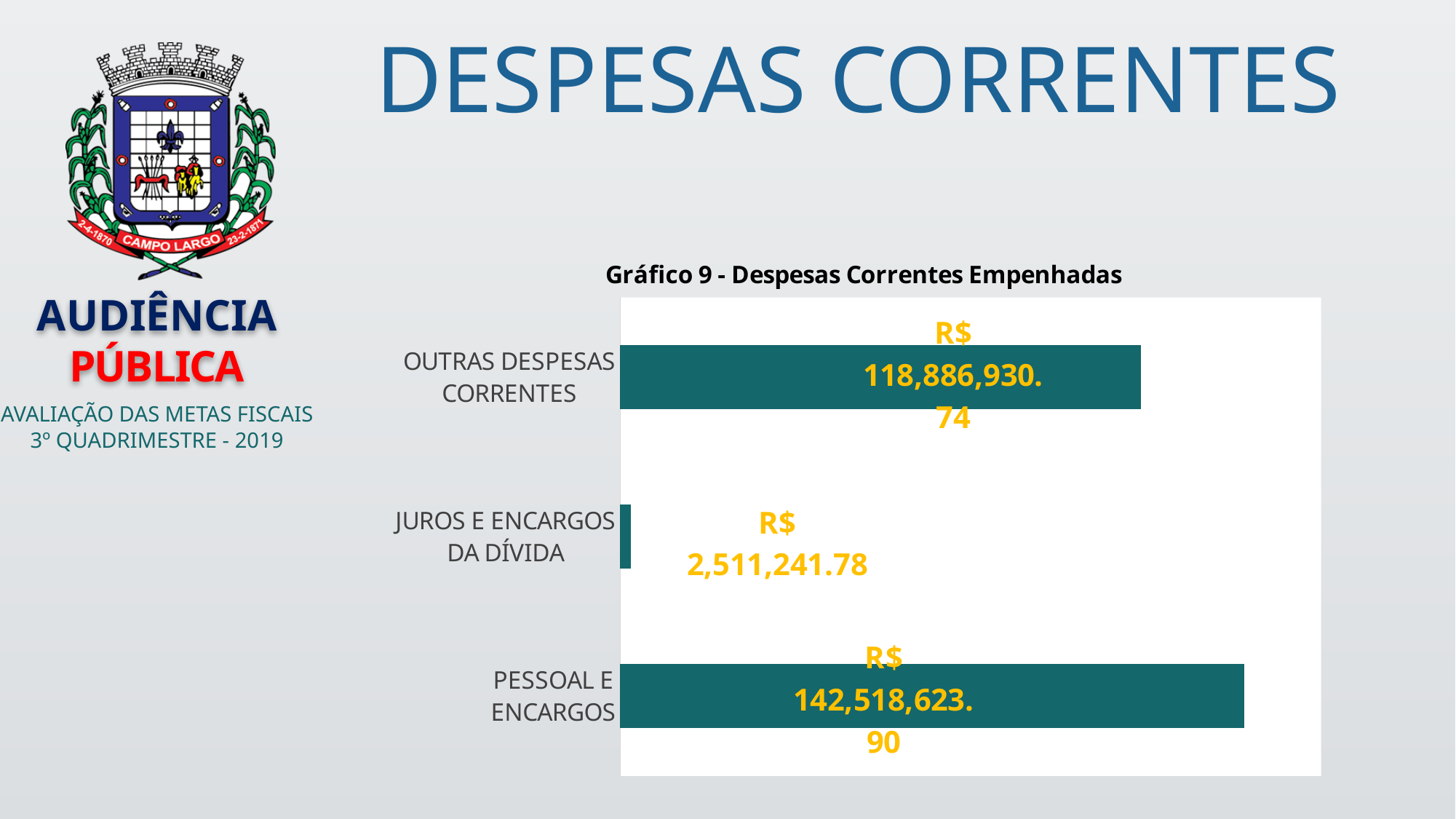
What is the value for JUROS E ENCARGOS DA DÍVIDA in Gráfico 9? R$ 2,511,241.78 Which is larger in Gráfico 9: PESSOAL E ENCARGOS or OUTRAS DESPESAS CORRENTES? PESSOAL E ENCARGOS What is the difference between PESSOAL E ENCARGOS and OUTRAS DESPESAS CORRENTES in Gráfico 9? R$ 23,631,693.16 What is the difference between OUTRAS DESPESAS CORRENTES and JUROS E ENCARGOS DA DÍVIDA in Gráfico 9? R$ 116,375,688.96 How many categories are shown in Gráfico 9? 3 What kind of chart is Gráfico 9? Bar chart What is the title of the chart on the slide? Gráfico 9 - Despesas Correntes Empenhadas Which category has the highest value in Gráfico 9? PESSOAL E ENCARGOS What is the value for OUTRAS DESPESAS CORRENTES in Gráfico 9? R$ 118,886,930.74 Which is larger in Gráfico 9: OUTRAS DESPESAS CORRENTES or JUROS E ENCARGOS DA DÍVIDA? OUTRAS DESPESAS CORRENTES Which category has the lowest value in Gráfico 9? JUROS E ENCARGOS DA DÍVIDA What is the value for PESSOAL E ENCARGOS in Gráfico 9? R$ 142,518,623.90